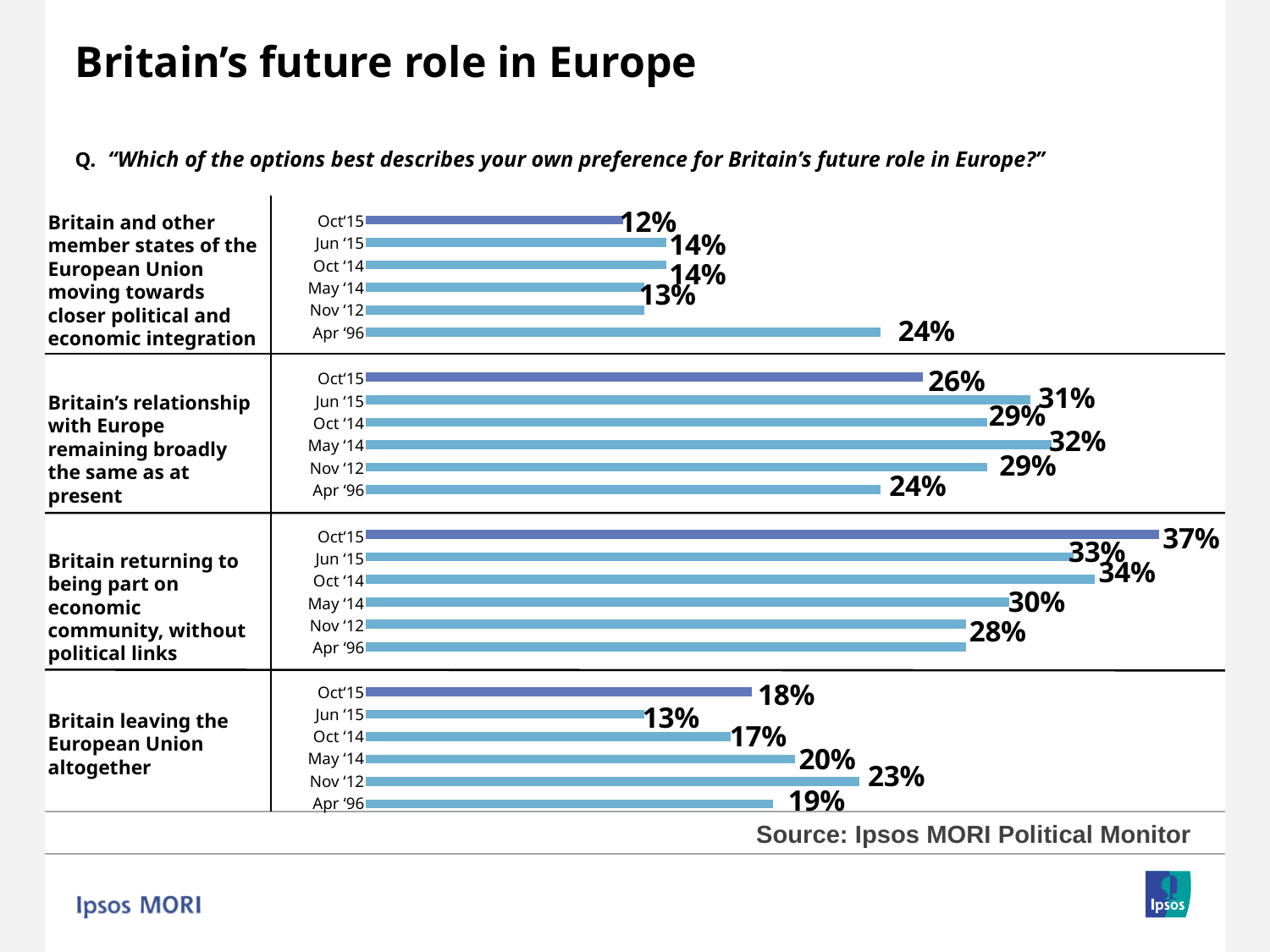
What type of chart is used on this slide? Bar chart In the chart for 'Britain leaving the European Union altogether', which date has the highest value? Nov '12 In the chart for 'Britain leaving the European Union altogether', what is the difference between the Nov '12 value and the Jun '15 value? 10 percentage points In the chart for 'Britain's relationship with Europe remaining broadly the same as at present', which is larger: the Oct'15 value or the Jun '15 value? Jun '15 In the chart for 'Britain leaving the European Union altogether', what is the value for Oct'15? 18% In the top chart ('Britain and other member states of the European Union moving towards closer political and economic integration'), what is the value for Apr '96? 24% In the chart for 'Britain's relationship with Europe remaining broadly the same as at present', what is the value for May '14? 32% In the chart for 'Britain's relationship with Europe remaining broadly the same as at present', which date has the lowest value? Apr '96 In the chart for 'Britain returning to being part on economic community, without political links', what is the value for Oct'15? 37% In the chart for 'Britain returning to being part on economic community, without political links', what is the difference between the Oct'15 value and the May '14 value? 7 percentage points How many dates (bars) are shown in each of the four charts? 6 In the chart for 'Britain leaving the European Union altogether', which date has the lowest value? Jun '15